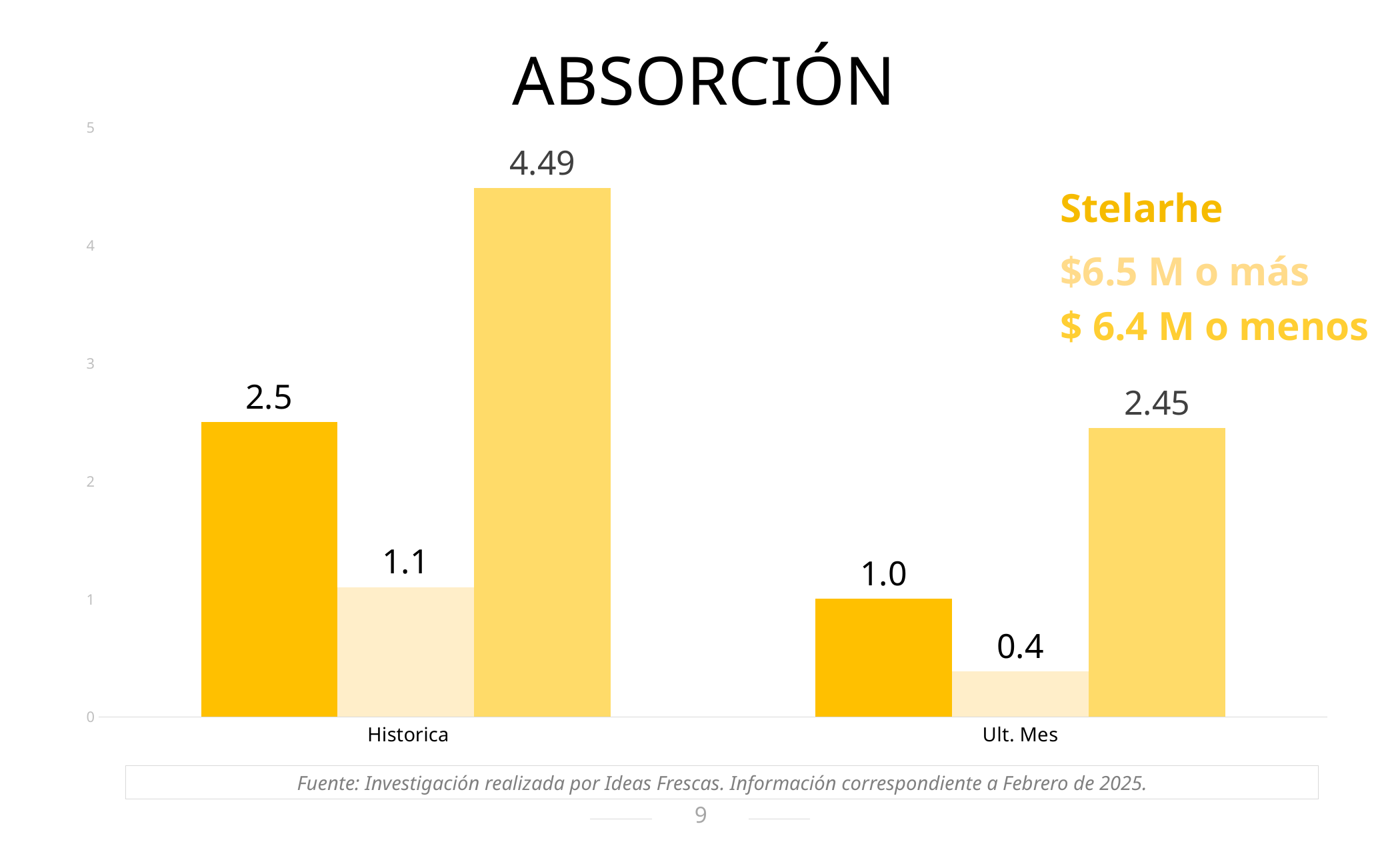
Which series has the lowest value in the Ult. Mes category? $6.5 M o más Which series has the highest value in the Historica category? $ 6.4 M o menos How many categories are shown on the x axis? 2 What is the value for Stelarhe in the Ult. Mes category? 1.0 What is the difference between the $ 6.4 M o menos values for Historica and Ult. Mes? 2.04 What type of chart is shown on the slide? Bar chart Which is larger: the Stelarhe value for Historica or the Stelarhe value for Ult. Mes? Historica What is the value for $ 6.4 M o menos in the Ult. Mes category? 2.45 What is the difference between the Stelarhe value and the $6.5 M o más value in the Historica category? 1.4 How many series does the legend list? 3 What is the value for $6.5 M o más in the Historica category? 1.1 What is the value for Stelarhe in the Historica category? 2.5